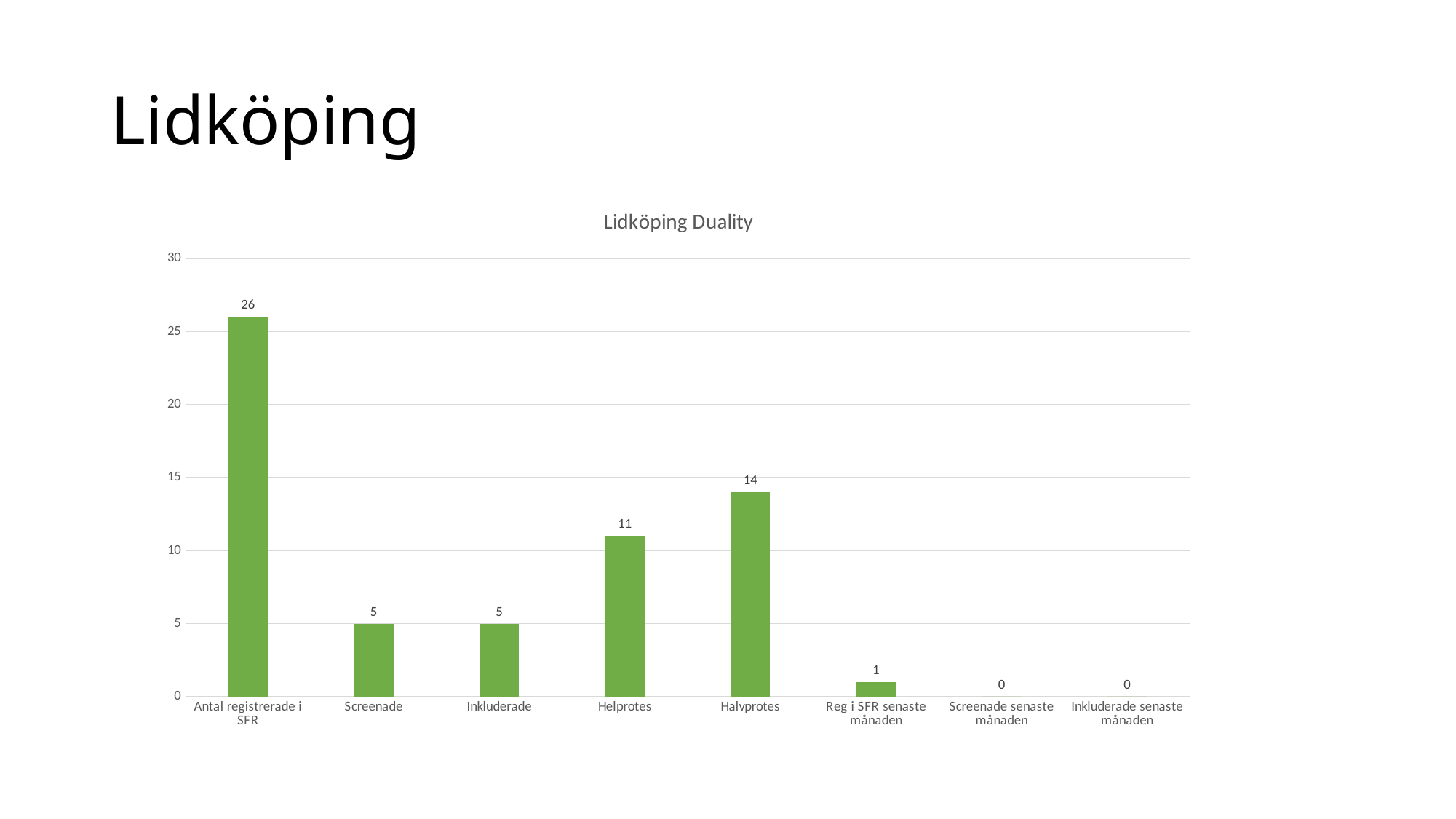
Is the value for Antal registrerade i SFR greater or less than 25? greater What is the value for Antal registrerade i SFR? 26 What kind of chart is this? bar chart What is the title of the chart? Lidköping Duality Which is larger, Helprotes or Halvprotes? Halvprotes What is the difference between Antal registrerade i SFR and Halvprotes? 12 How many categories are shown on the x axis? 8 What is the value for Helprotes? 11 What is the value for Reg i SFR senaste månaden? 1 What is the value for Halvprotes? 14 Which category has the highest value? Antal registrerade i SFR What is the difference between Halvprotes and Helprotes? 3